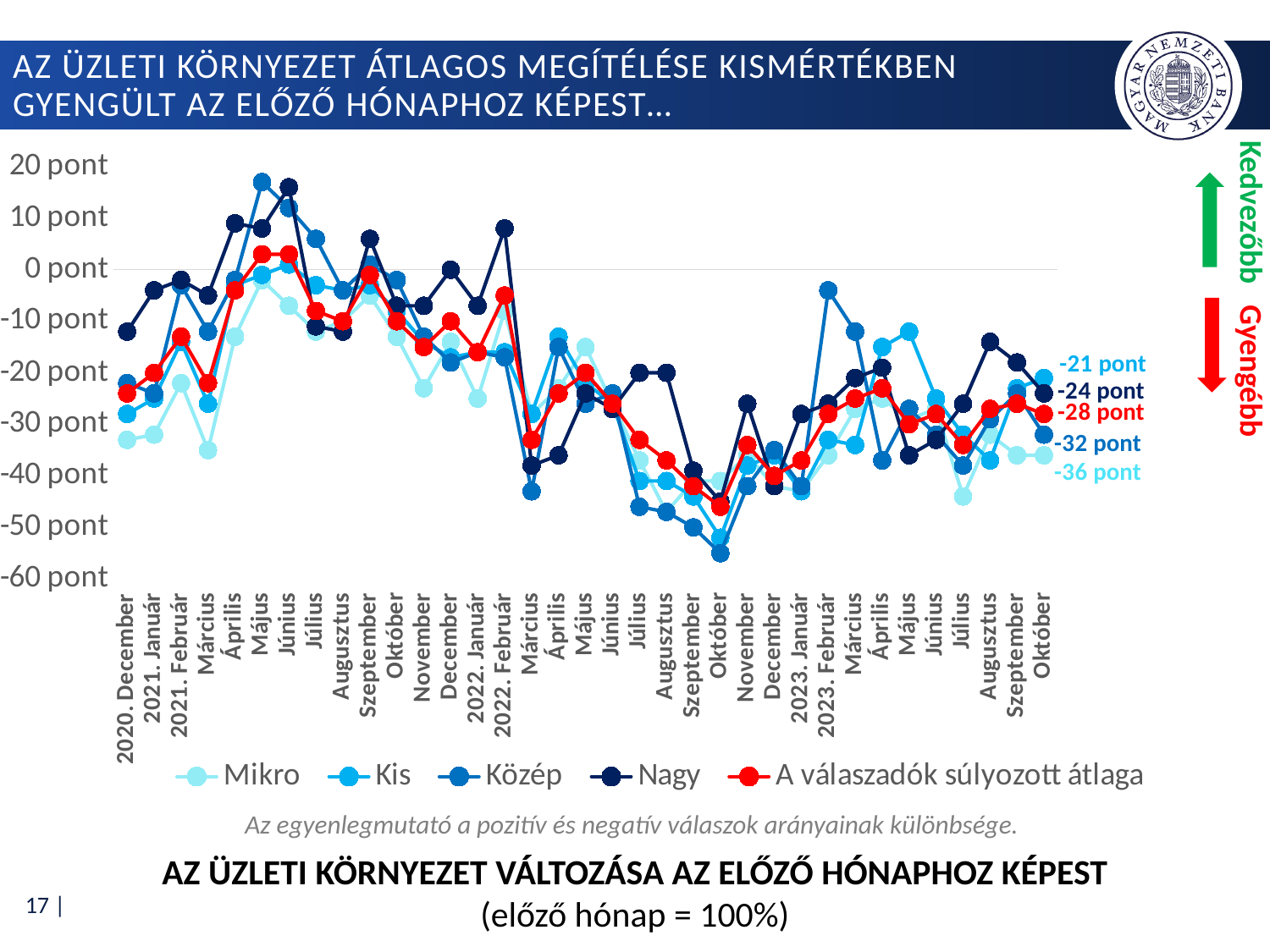
What is the value for Közép in 2023 Október? -32 pont In 2023 Október, which is larger: the value for Nagy or the value for Közép? Nagy What is the value for Mikro in 2023 Október? -36 pont Is the value for Közép in 2021 Május greater or less than 10 pont? greater What kind of chart is shown on the slide? line chart What is the difference between the Kis and Mikro values in 2023 Október? 15 pont What is the value of 'A válaszadók súlyozott átlaga' in 2023 Október? -28 pont Which series has the highest value in 2023 Október? Kis What is the value for Nagy in 2023 Október? -24 pont Which series has the lowest value in 2023 Október? Mikro How many series does the legend list? 5 What is the value for Kis in 2023 Október? -21 pont